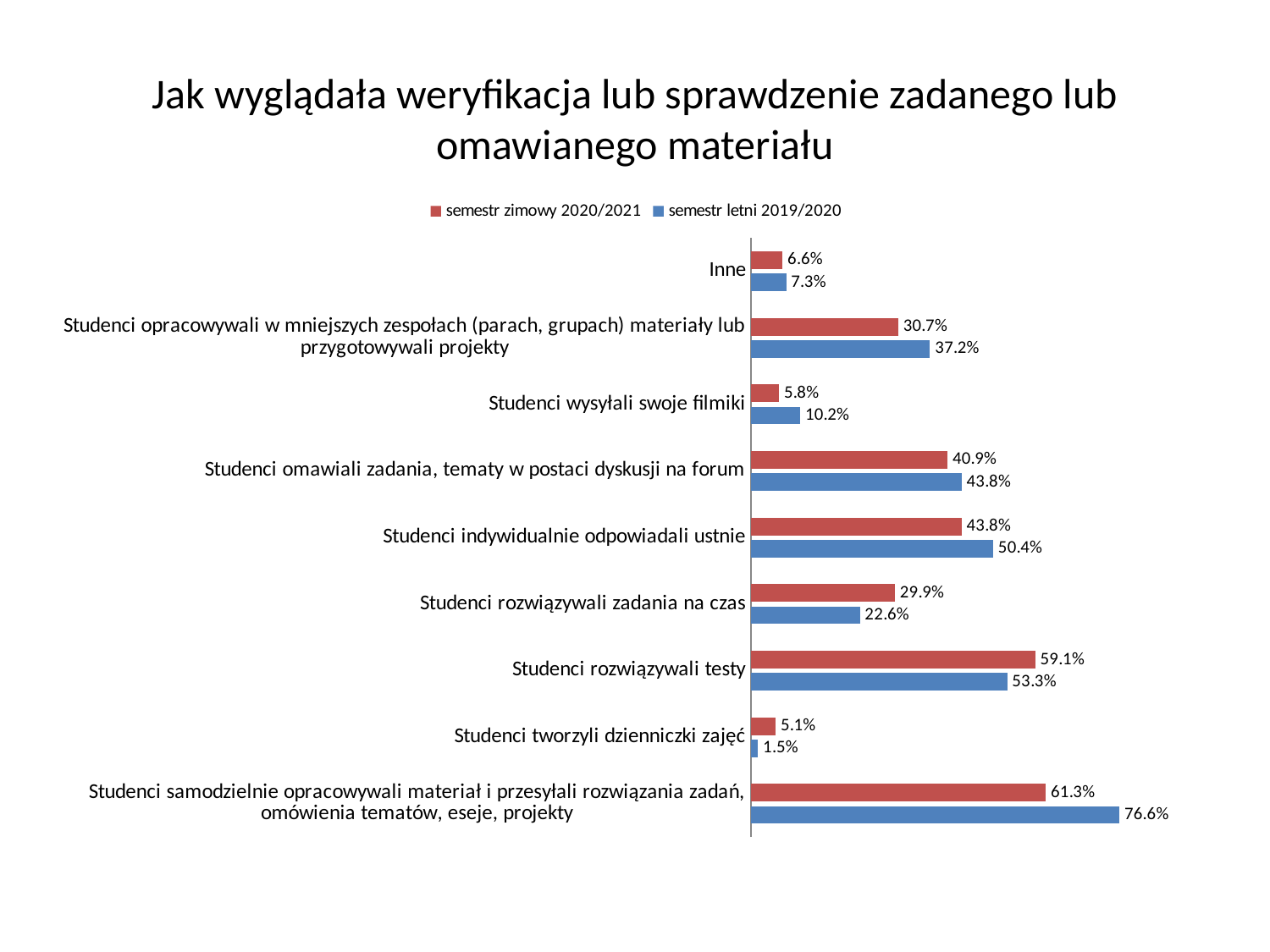
Which colour represents semestr letni 2019/2020 in the chart? blue What is the value for 'Studenci wysyłali swoje filmiki' in semestr letni 2019/2020? 10.2% What is the difference between the semestr letni 2019/2020 and semestr zimowy 2020/2021 values for 'Studenci indywidualnie odpowiadali ustnie'? 6.6% Which category has the lowest value in semestr letni 2019/2020? Studenci tworzyli dzienniczki zajęć What type of chart is shown on the slide? bar chart For 'Studenci rozwiązywali zadania na czas', which semester has the larger value? semestr zimowy 2020/2021 How many series does the legend list? 2 What is the value for 'Inne' in semestr zimowy 2020/2021? 6.6% How many categories are shown on the chart? 9 What is the value for 'Studenci rozwiązywali testy' in semestr zimowy 2020/2021? 59.1% Which category has the highest value in semestr letni 2019/2020? Studenci samodzielnie opracowywali materiał i przesyłali rozwiązania zadań, omówienia tematów, eseje, projekty What is the difference between the two semesters for 'Studenci samodzielnie opracowywali materiał i przesyłali rozwiązania zadań, omówienia tematów, eseje, projekty'? 15.3%